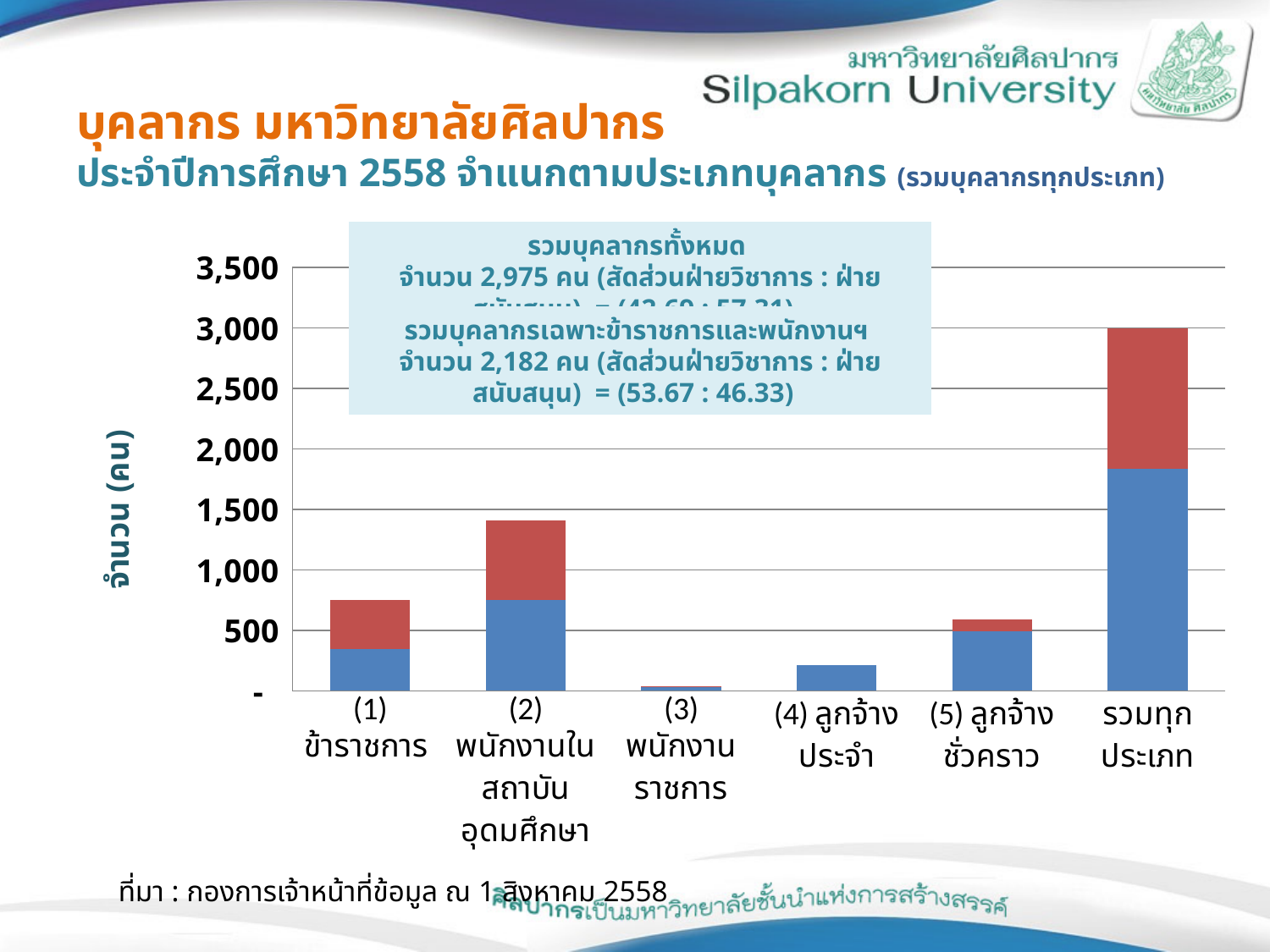
What kind of chart is shown on the slide? bar chart Which category has the shortest bar in the chart? (3) พนักงานราชการ Is the total bar height for (4) ลูกจ้างประจำ greater or less than 500? less Is the total bar height for รวมทุกประเภท greater or less than 2,500? greater Which bar is taller: (4) ลูกจ้างประจำ or (5) ลูกจ้างชั่วคราว? (5) ลูกจ้างชั่วคราว Is the total bar height for (1) ข้าราชการ greater or less than 500? greater What two colours are used for the stacked segments in the bars? blue and red Which bar is taller: (1) ข้าราชการ or (2) พนักงานในสถาบันอุดมศึกษา? (2) พนักงานในสถาบันอุดมศึกษา How many categories are shown on the x axis of the chart? 6 What is the title of the vertical axis of the chart? จำนวน (คน) Which category has the tallest bar in the chart? รวมทุกประเภท